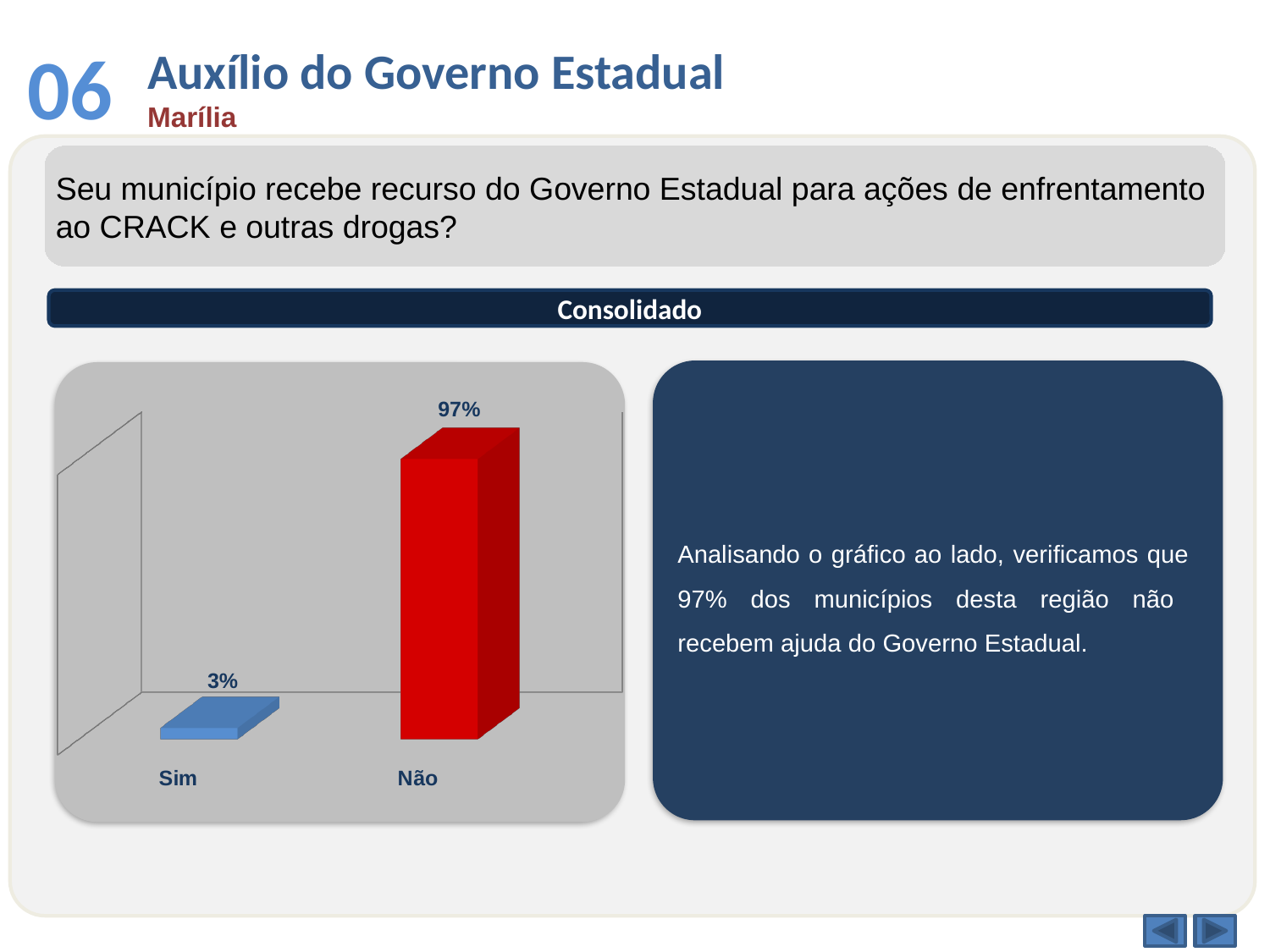
What is the value for "Não" in the chart? 97% What is the value for "Sim" in the chart? 3% Which is larger, the value for "Sim" or the value for "Não"? Não What colour is the bar for "Não"? Red What colour is the bar for "Sim"? Blue What kind of chart is shown on the slide? Bar chart What is the difference between the values for "Não" and "Sim"? 94% Which category has the highest value in the chart? Não Which category has the lowest value in the chart? Sim How many categories are shown in the chart? 2